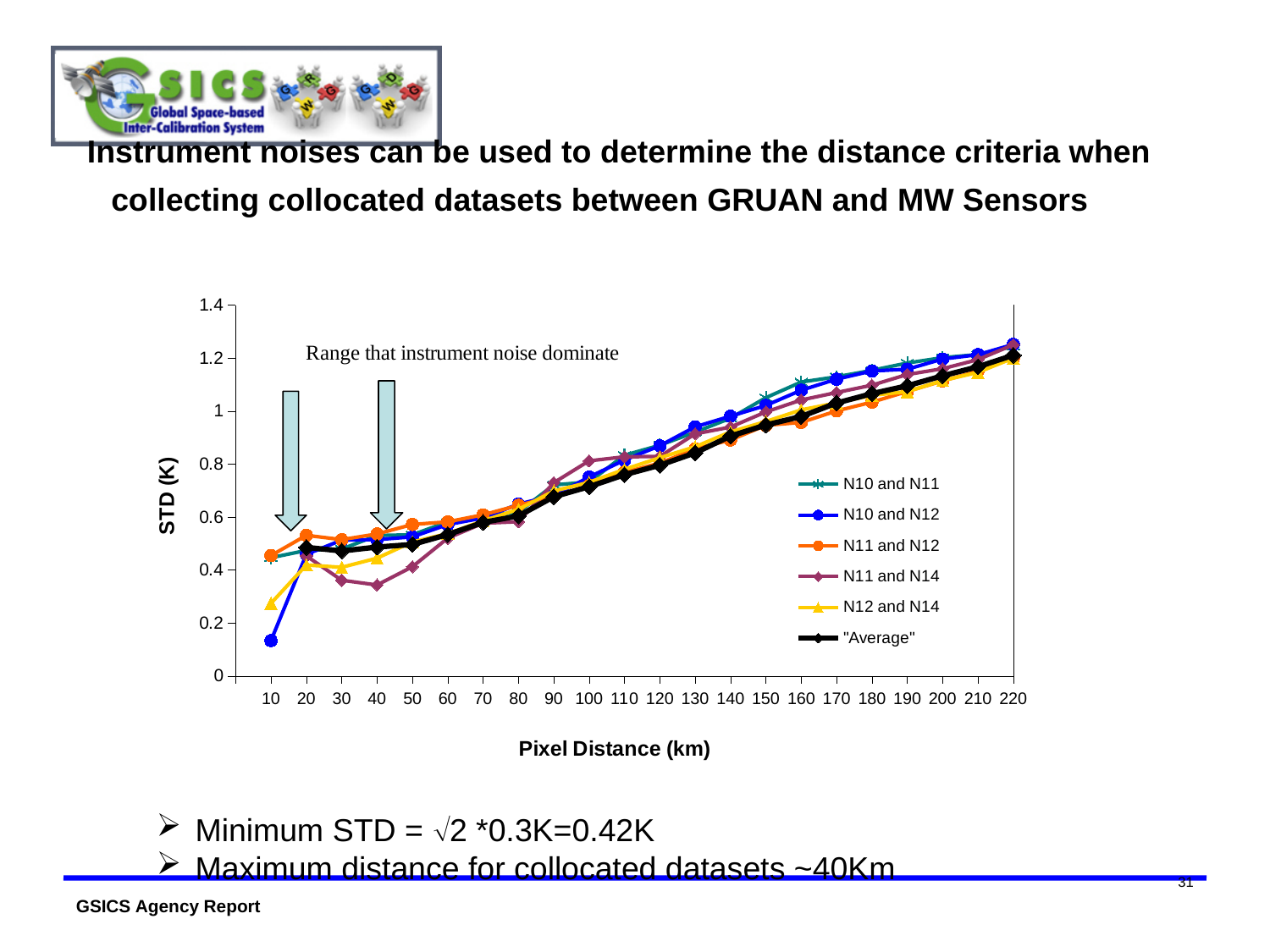
What is the label of the y axis? STD (K) Is the value for "Average" at 220 km greater or less than 1? greater How many pixel distance values are marked along the x axis? 22 Is the value for N12 and N14 at 10 km greater or less than 0.4? less Is the value for N11 and N12 at 40 km greater or less than 0.4? greater How many series does the legend list? 6 At 10 km, which series has the lowest STD value? N10 and N12 What kind of chart is shown on the slide? line chart What is the label of the x axis? Pixel Distance (km) At 40 km, which is larger: the value for N11 and N12 or the value for N11 and N14? N11 and N12 Do the STD values generally rise or fall as pixel distance increases from 60 km to 220 km? rise